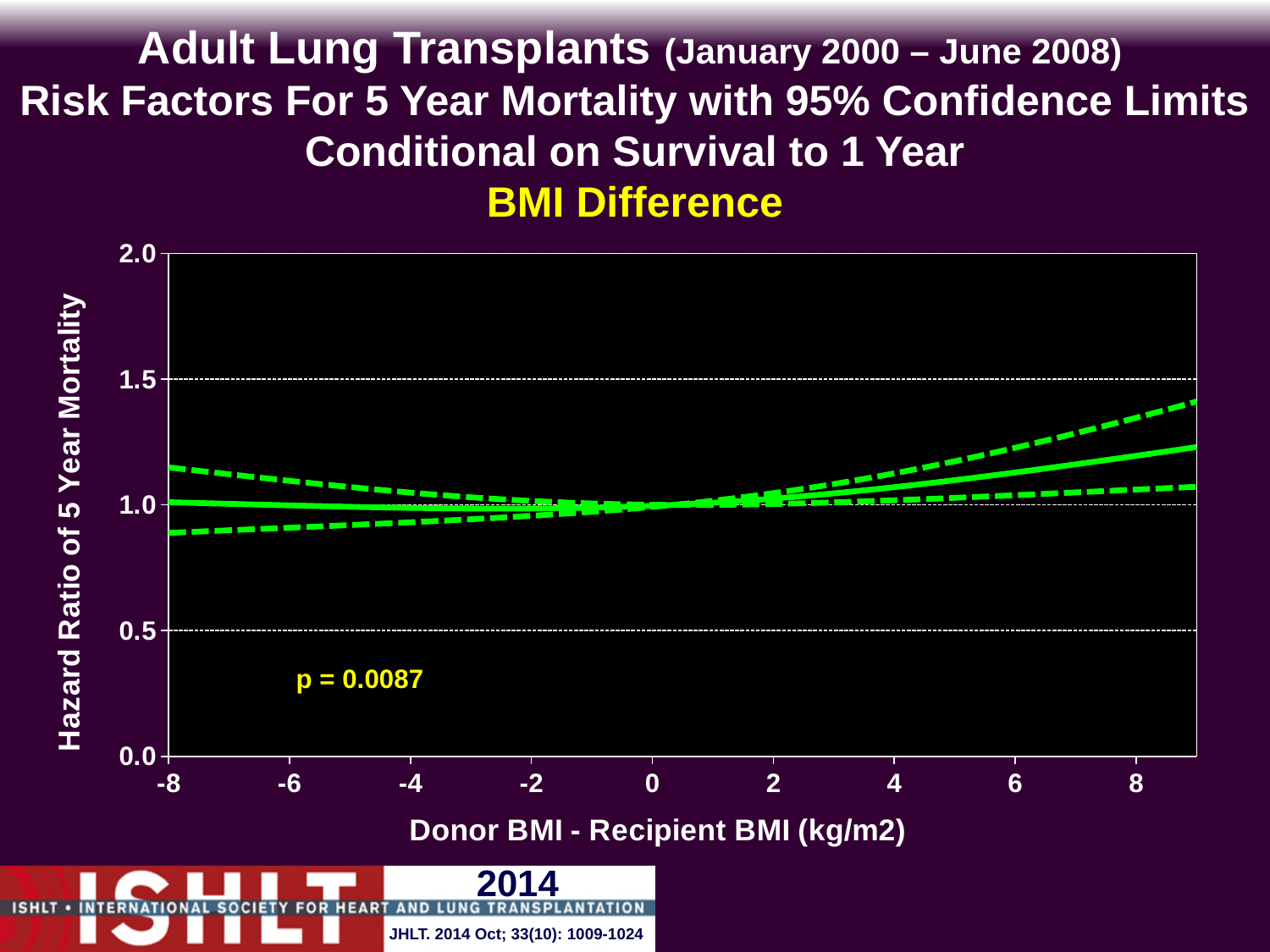
How many lines are plotted on the chart? 3 What kind of chart is shown on the slide? line chart What is the label of the y axis? Hazard Ratio of 5 Year Mortality What is the label of the x axis? Donor BMI - Recipient BMI (kg/m2) Is the hazard ratio (solid line) at a BMI difference of 8 greater or less than 1.5? less What is the highest value shown on the y axis? 2.0 Is the hazard ratio (solid line) at a BMI difference of 8 greater or less than 1.0? greater Is the lower 95% confidence limit (lower dashed line) at a BMI difference of -8 greater or less than 1.0? less Does the solid hazard ratio line rise or fall as Donor BMI - Recipient BMI increases from -8 to 8? rise